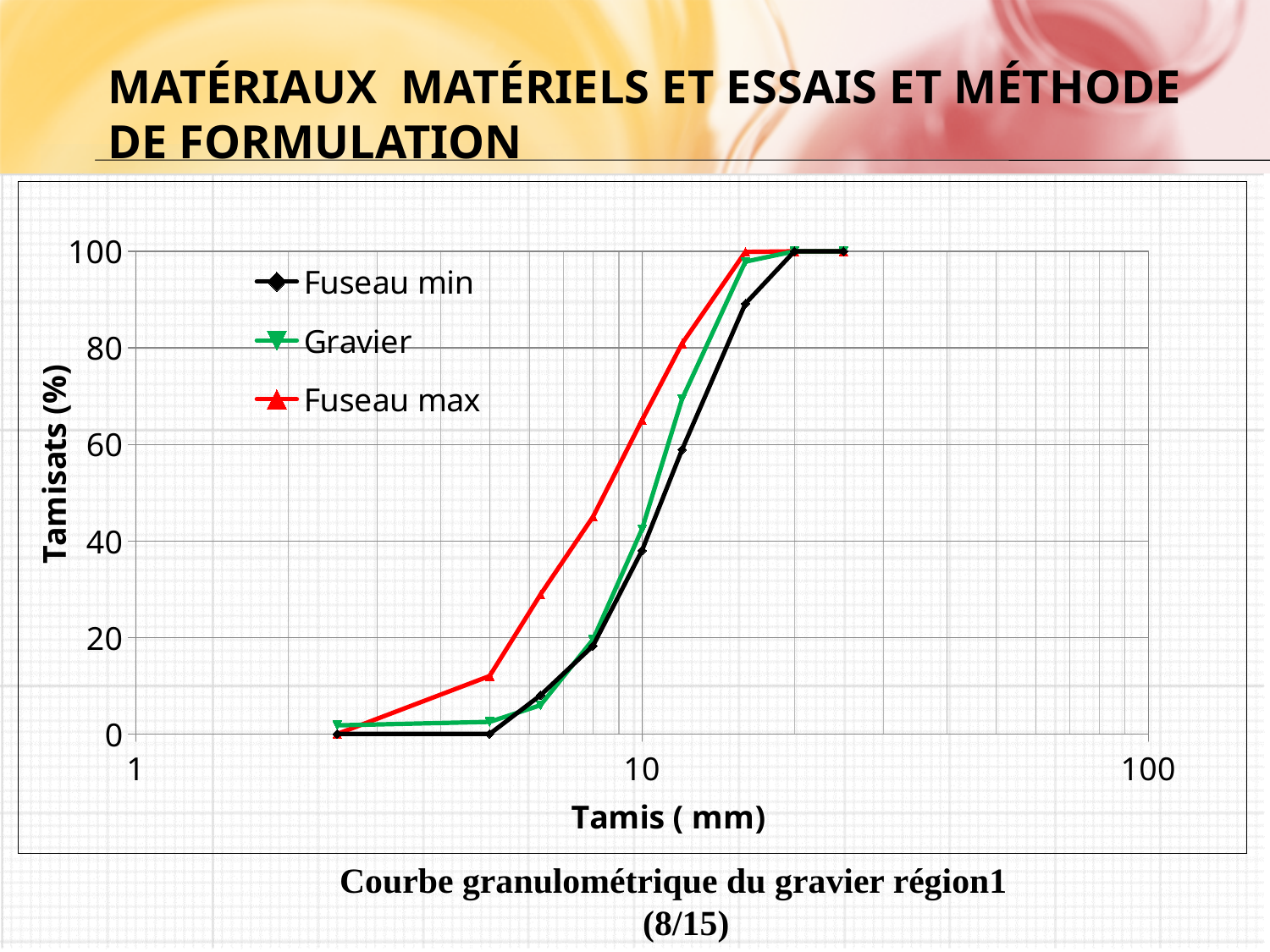
What kind of chart is shown on the slide? line chart At 10 mm, is the value for Fuseau min greater or less than 60? less At 10 mm, which series has the larger value, Gravier or Fuseau max? Fuseau max What is the title of the x axis? Tamis ( mm) At 10 mm, is the value for Fuseau max greater or less than 50? greater What value do all three series reach at the right end of the curves? 100 Which series has the highest value at 10 mm? Fuseau max At 10 mm, which series has the larger value, Fuseau max or Fuseau min? Fuseau max Do the values of the Gravier series rise or fall as the sieve size increases along the x axis? rise At 10 mm, is the value for Gravier greater or less than 20? greater How many series does the legend list? 3 What are the names of the series in the legend? Fuseau min, Gravier, Fuseau max